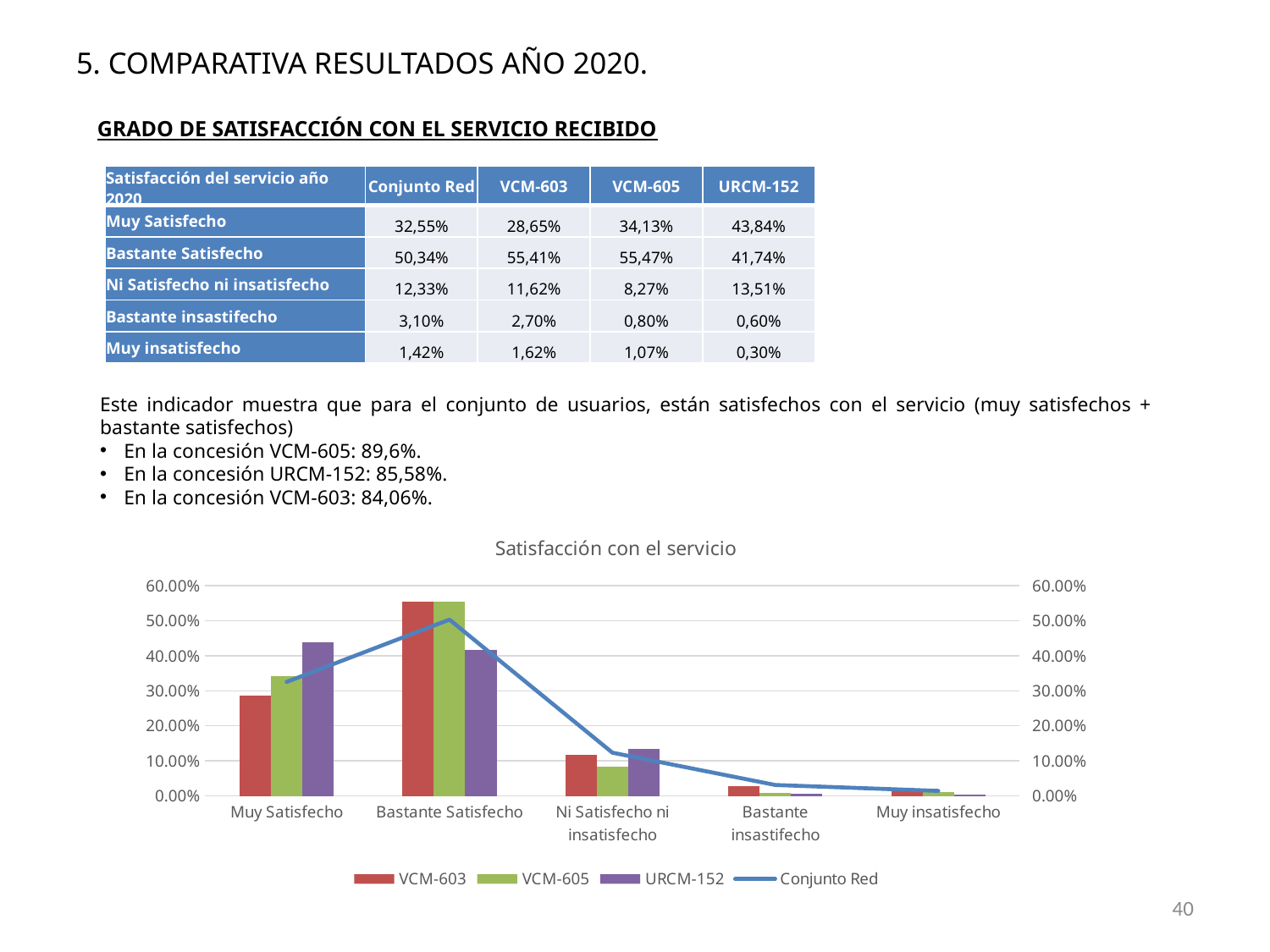
How many categories are shown on the x axis of the 'Satisfacción con el servicio' chart? 5 In the 'Satisfacción con el servicio' chart, is the VCM-603 bar for Muy Satisfecho greater or less than 30%? less In the 'Satisfacción con el servicio' chart, which category has the tallest VCM-603 bar? Bastante Satisfecho In the 'Satisfacción con el servicio' chart, does the Conjunto Red line rise or fall from Bastante Satisfecho to Muy insatisfecho? fall In the 'Satisfacción con el servicio' chart, for Muy Satisfecho, which bar is taller: VCM-605 or URCM-152? URCM-152 What is the title of the chart on the slide? Satisfacción con el servicio How many series does the legend of the 'Satisfacción con el servicio' chart list? 4 In the 'Satisfacción con el servicio' chart, which series is drawn as a line rather than bars? Conjunto Red In the 'Satisfacción con el servicio' chart, for Ni Satisfecho ni insatisfecho, which bar is taller: VCM-603 or VCM-605? VCM-603 In the 'Satisfacción con el servicio' chart, is the URCM-152 bar for Muy Satisfecho greater or less than 40%? greater According to the table on the slide, what is the Conjunto Red value for Bastante Satisfecho? 50,34% What kind of chart is 'Satisfacción con el servicio'? A bar chart with a line series